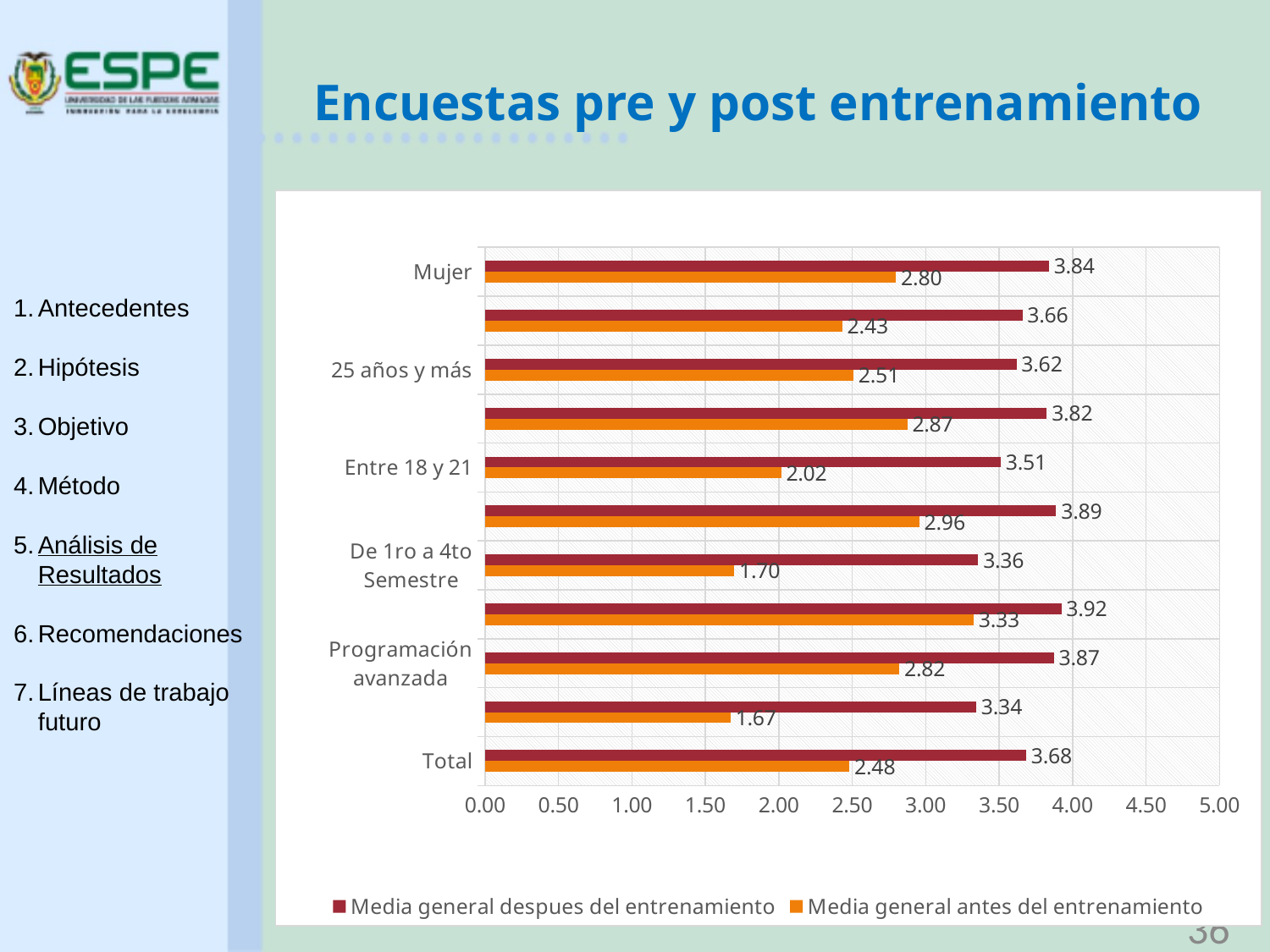
What is the difference between the 'despues' and 'antes' values for De 1ro a 4to Semestre? 1.66 What kind of chart is shown on the slide? bar chart How many series does the legend list? 2 What is the value of 'Media general antes del entrenamiento' for Total? 2.48 Is the 'Media general antes del entrenamiento' value for De 1ro a 4to Semestre greater or less than 2.00? less What is the value of 'Media general despues del entrenamiento' for Mujer? 3.84 What is the value of 'Media general antes del entrenamiento' for Mujer? 2.80 What is the value of 'Media general despues del entrenamiento' for Total? 3.68 What is the title of the slide containing the chart? Encuestas pre y post entrenamiento What is the value of 'Media general antes del entrenamiento' for Programación avanzada? 2.82 What is the difference between the 'despues' and 'antes' values for Entre 18 y 21? 1.49 Which has a larger 'Media general antes del entrenamiento' value: 25 años y más or Entre 18 y 21? 25 años y más